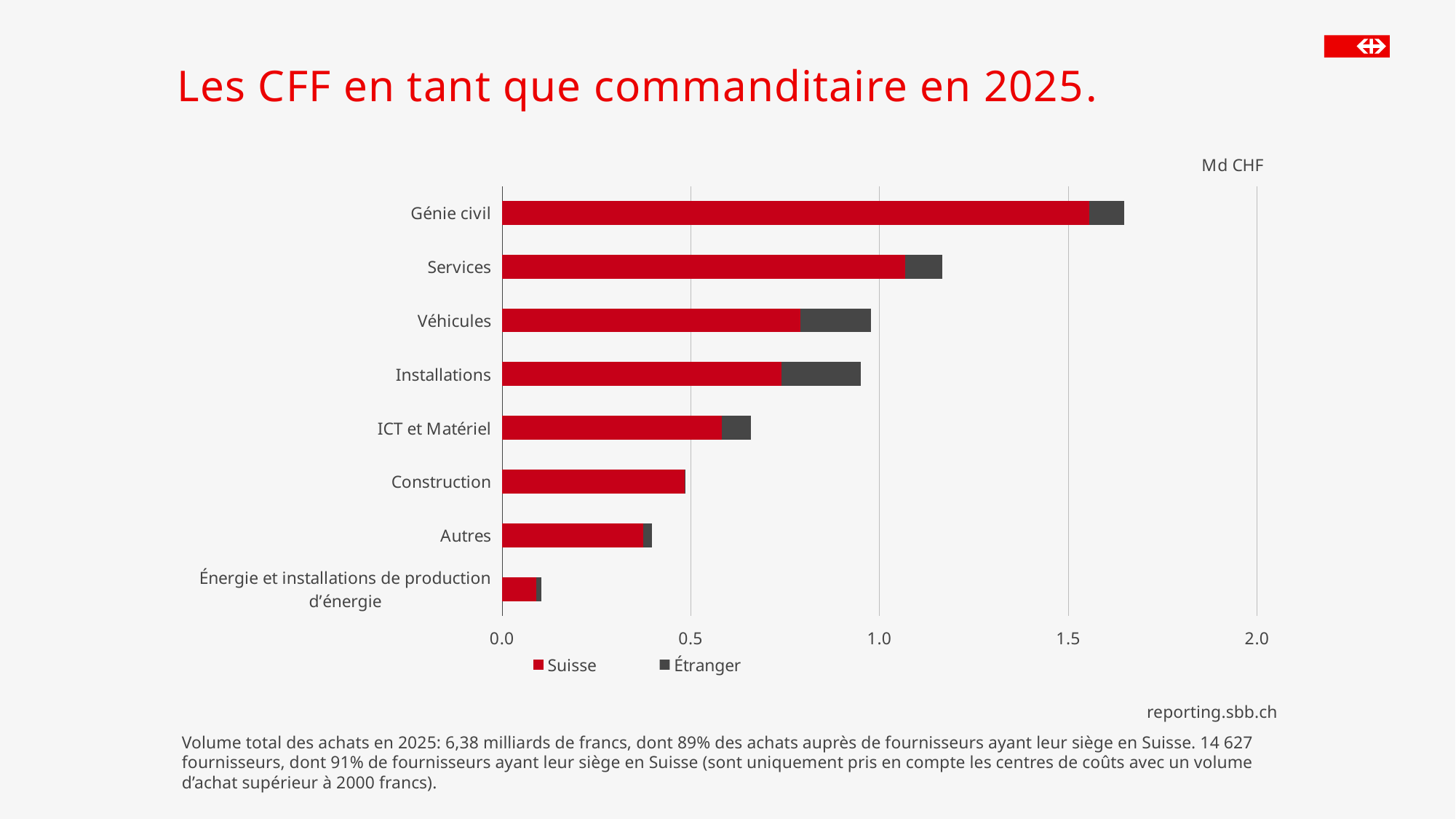
Is the total value for Installations greater or less than 1.0? less Which category has the longest total bar? Génie civil Is the total value for Services greater or less than 1.0? greater What kind of chart is shown on the slide? bar chart Which category has the shortest total bar? Énergie et installations de production d'énergie How many categories are shown on the chart? 8 Is the total value for Autres greater or less than 0.5? less What unit is indicated above the chart's axis? Md CHF How many series does the legend list? 2 Which has a larger total bar, Services or Véhicules? Services